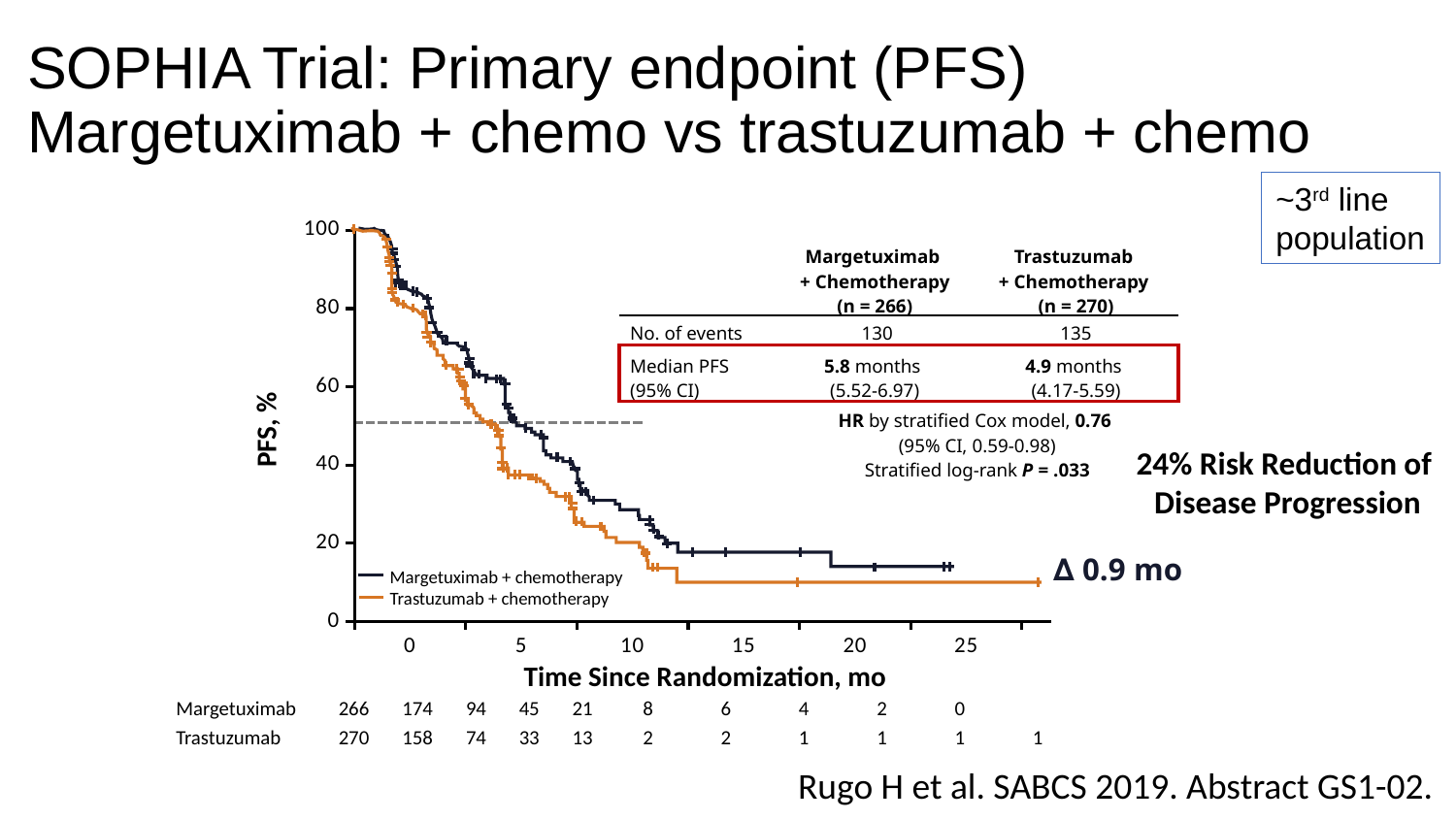
What is the median PFS for the trastuzumab + chemotherapy arm? 4.9 months Which arm has the higher median PFS? Margetuximab + chemotherapy What kind of chart is shown on the slide? Line chart (Kaplan-Meier survival curve) Do the PFS curves rise or fall as time since randomization increases? Fall What is the median PFS for the margetuximab + chemotherapy arm? 5.8 months How many events were recorded in the trastuzumab + chemotherapy arm? 135 Is the PFS value for the trastuzumab + chemotherapy curve at 5 months greater or less than 60? less How many series does the chart legend list? 2 What is the hazard ratio by stratified Cox model shown on the slide? 0.76 What is the difference in median PFS between the two arms? 0.9 months What is the label of the y axis? PFS, %